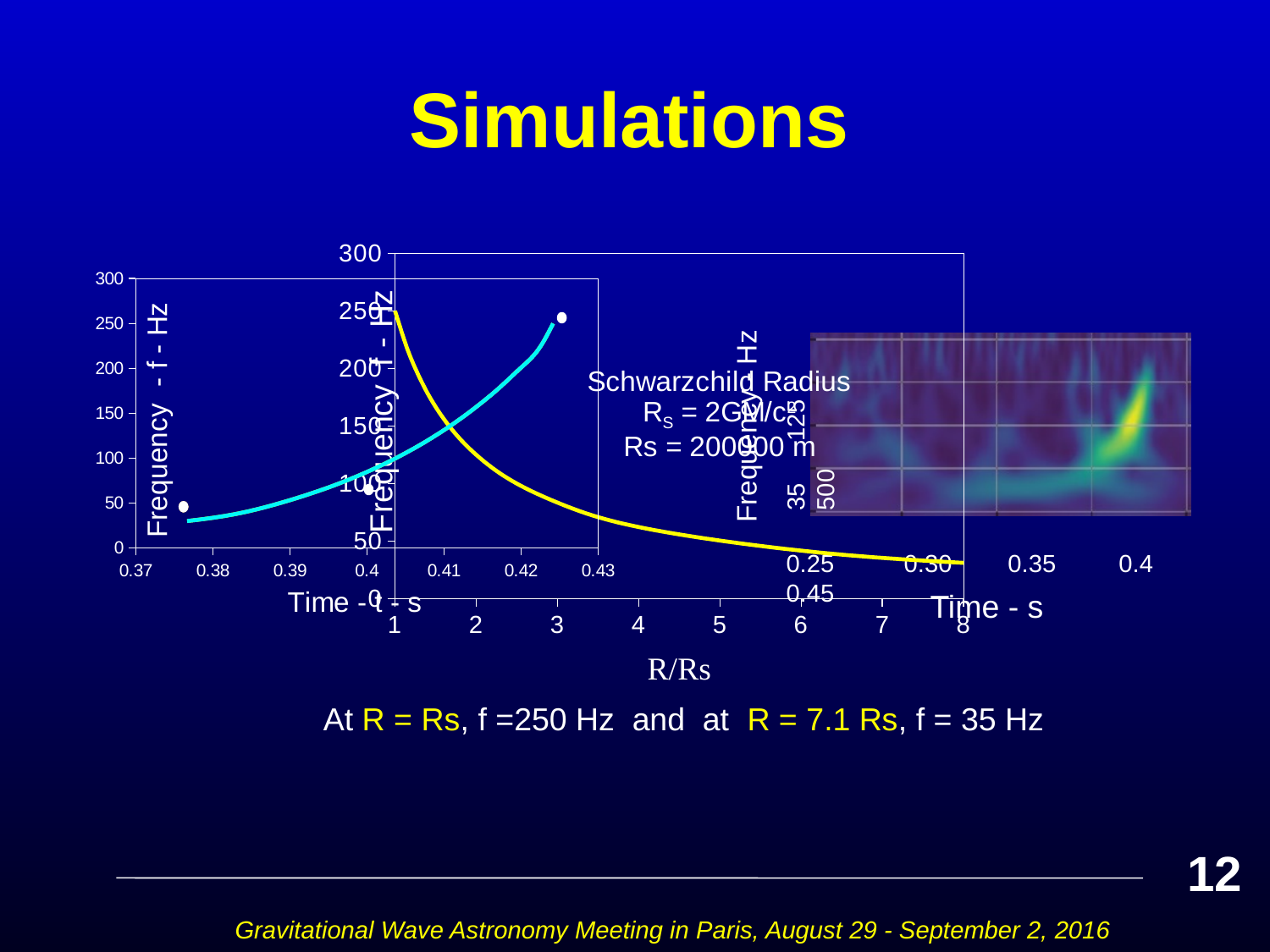
In the chart with the x axis 'R/Rs', is the value of the yellow curve at R/Rs = 4 greater or less than 100? less In the chart with the x axis 'R/Rs', does the yellow curve rise or fall as R/Rs increases? falls In the chart with the x axis 'Time - t - s', is the value of the cyan curve at time 0.41 greater or less than 100? greater What is the x axis label of the chart showing the yellow curve? R/Rs What kind of chart is the chart on the left with the x axis labelled 'Time - t - s'? line chart In the chart with the x axis 'Time - t - s', is the value of the cyan curve at time 0.42 greater or less than 150? greater In the chart with the x axis 'R/Rs', what is the frequency at R = 7.1 Rs? 35 Hz In the chart with the x axis 'R/Rs', what is the difference between the frequency at R = Rs and the frequency at R = 7.1 Rs? 215 Hz How many labelled tick marks are on the x axis of the chart with the x axis 'Time - t - s'? 7 In the chart with the x axis 'R/Rs', is the frequency larger at R = Rs or at R = 7.1 Rs? R = Rs In the chart with the x axis 'R/Rs', what is the frequency at R = Rs? 250 Hz In the chart with the x axis 'Time - t - s', does the cyan curve rise or fall as time increases? rises